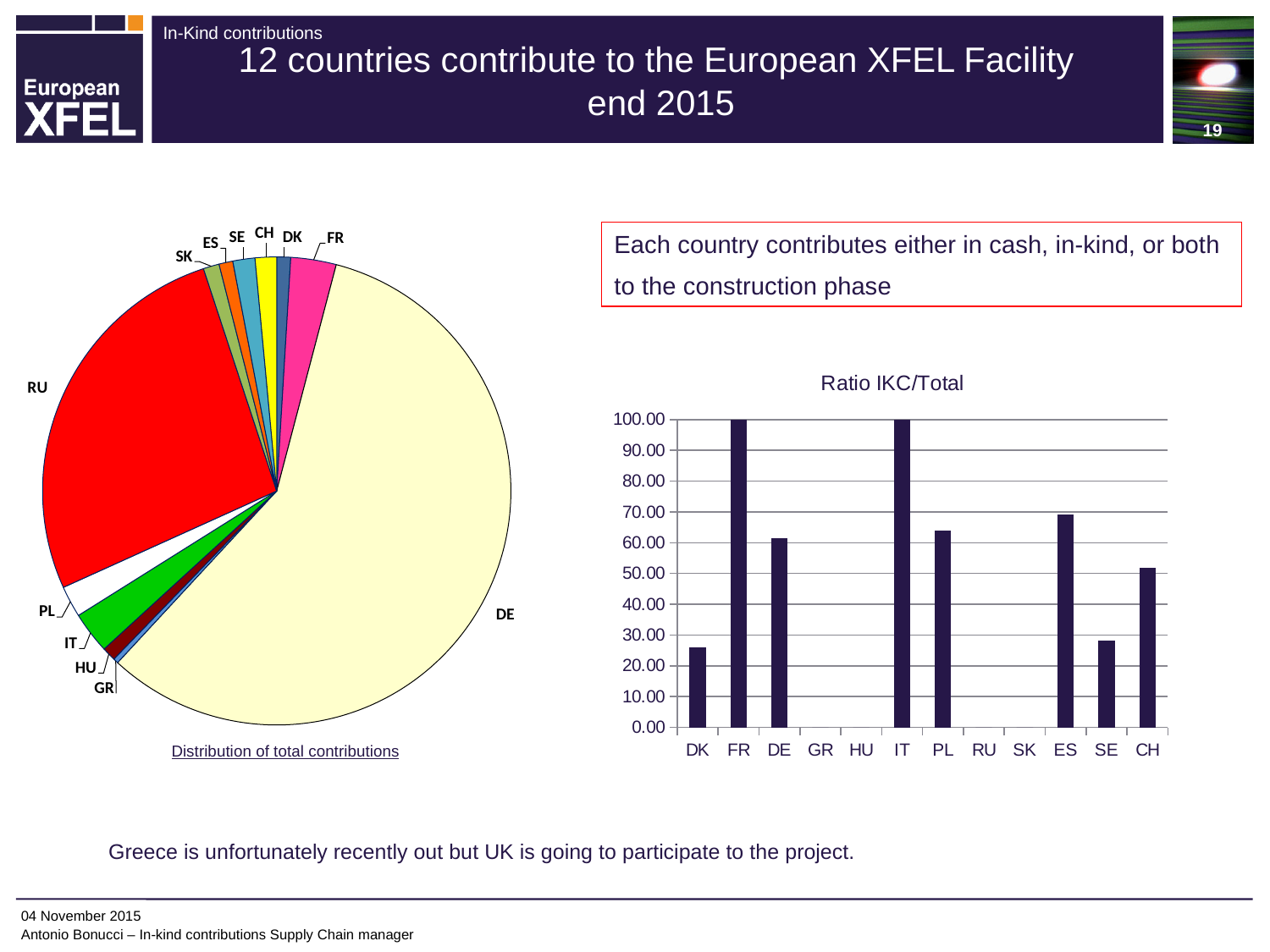
In the 'Ratio IKC/Total' chart, is the value for ES greater or less than 60.00? greater What is the title of the bar chart on the right of the slide? Ratio IKC/Total What kind of chart is the 'Ratio IKC/Total' chart? bar chart In the 'Ratio IKC/Total' chart, what is the value for FR? 100.00 In the 'Ratio IKC/Total' chart, which countries have the highest value? FR and IT In the 'Ratio IKC/Total' chart, is the value for CH greater or less than 60.00? less In the 'Distribution of total contributions' pie chart, which country has the largest slice? DE In the 'Ratio IKC/Total' chart, is the value for DK greater or less than 30.00? less What kind of chart is the chart on the left of the slide? pie chart How many countries are shown on the x axis of the 'Ratio IKC/Total' chart? 12 In the 'Ratio IKC/Total' chart, which is larger, the value for ES or the value for DE? ES In the 'Ratio IKC/Total' chart, how many countries have a value of 0.00? 4